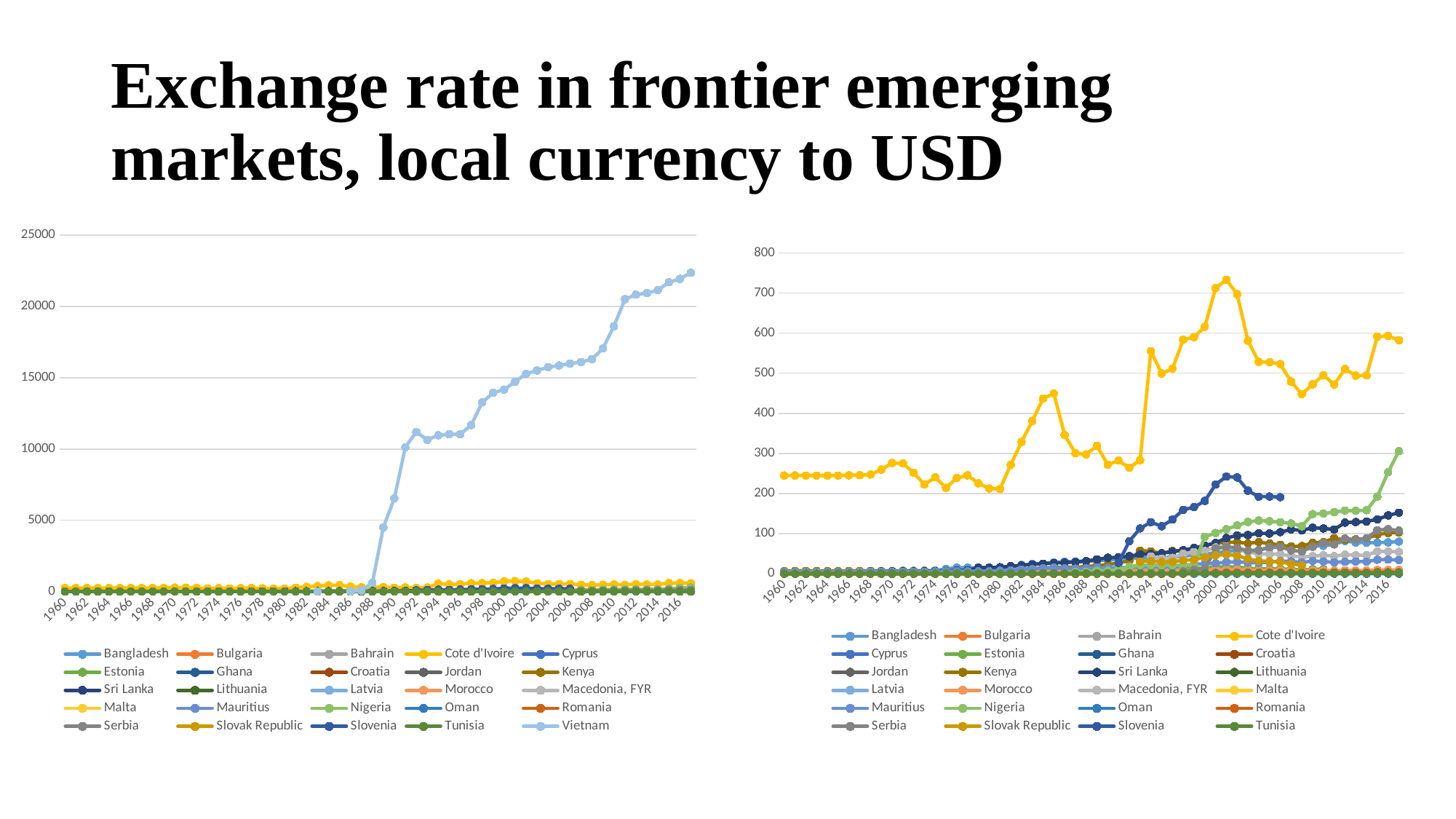
How many series does the legend of the left chart list? 25 On the left chart, is the value for Vietnam in 2016 greater or less than 20000? greater On the left chart, does the Vietnam series generally rise or fall from 1960 to 2016? rise On the right chart, is the value for Cote d'Ivoire in 2000 greater or less than 600? greater On the right chart, which is larger in 2016, the value for Cote d'Ivoire or the value for Ghana? Cote d'Ivoire How many series does the legend of the right chart list? 24 What is the highest value shown on the y axis of the right chart? 800 Which series appears in the legend of the left chart but not in the legend of the right chart? Vietnam On the right chart, is the value for Cote d'Ivoire in 1960 greater or less than 300? less On the left chart, which series reaches the highest values? Vietnam On the right chart, which series reaches the highest values? Cote d'Ivoire What kind of chart is the left chart on the slide? line chart